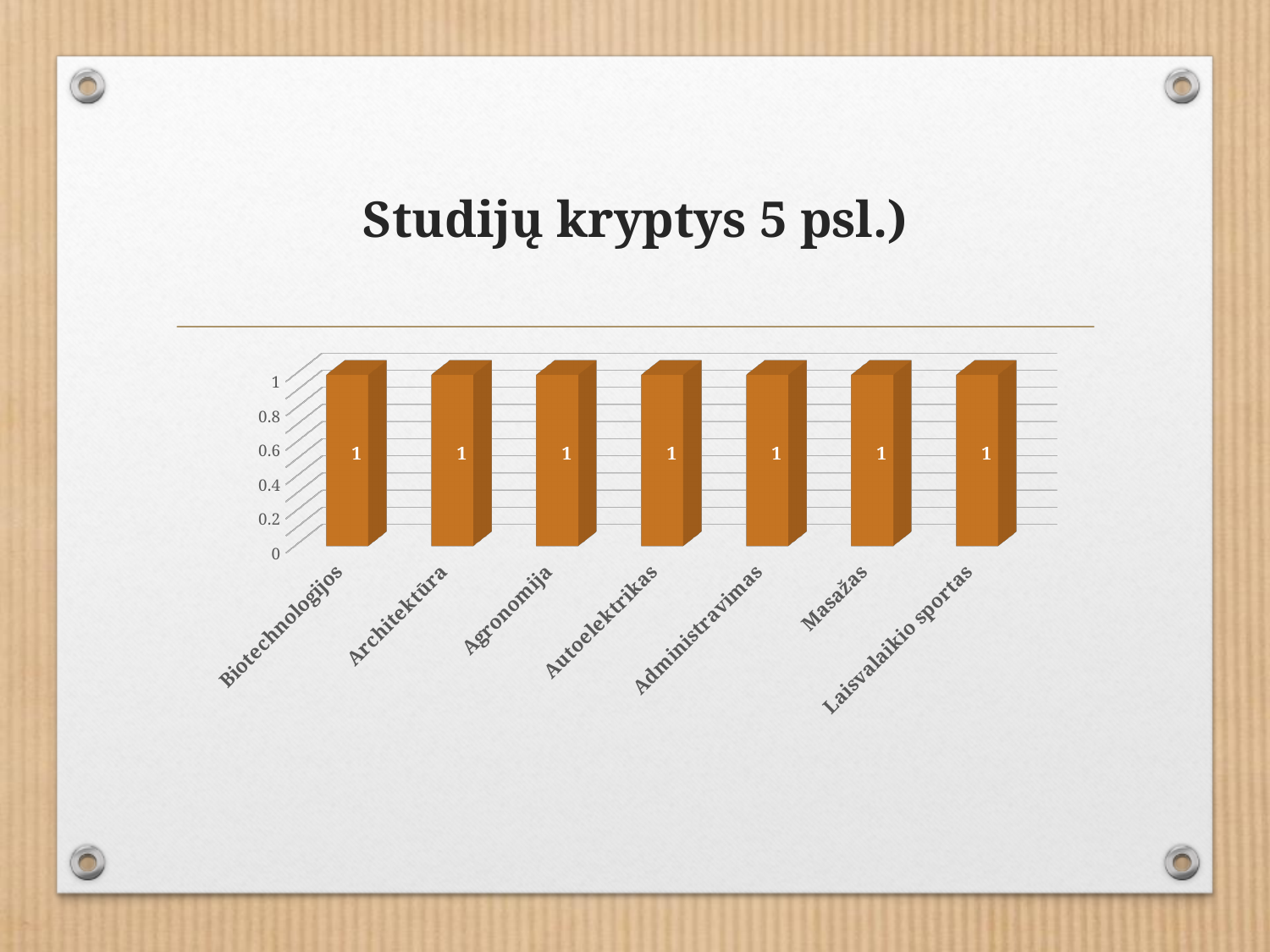
What is the value for Autoelektrikas? 1 What is the value for Laisvalaikio sportas? 1 What colour are the bars in the chart? orange How many categories are shown on the x axis? 7 What is the value for Agronomija? 1 What is the value for Architektūra? 1 What kind of chart is shown on the slide? bar chart Is the value for Masažas greater or less than 0.5? greater What is the value for Biotechnologijos? 1 Do the values rise, fall or stay the same across the categories from left to right? stay the same What is the difference between the values for Masažas and Administravimas? 0 What is the title of the slide? Studijų kryptys 5 psl.)